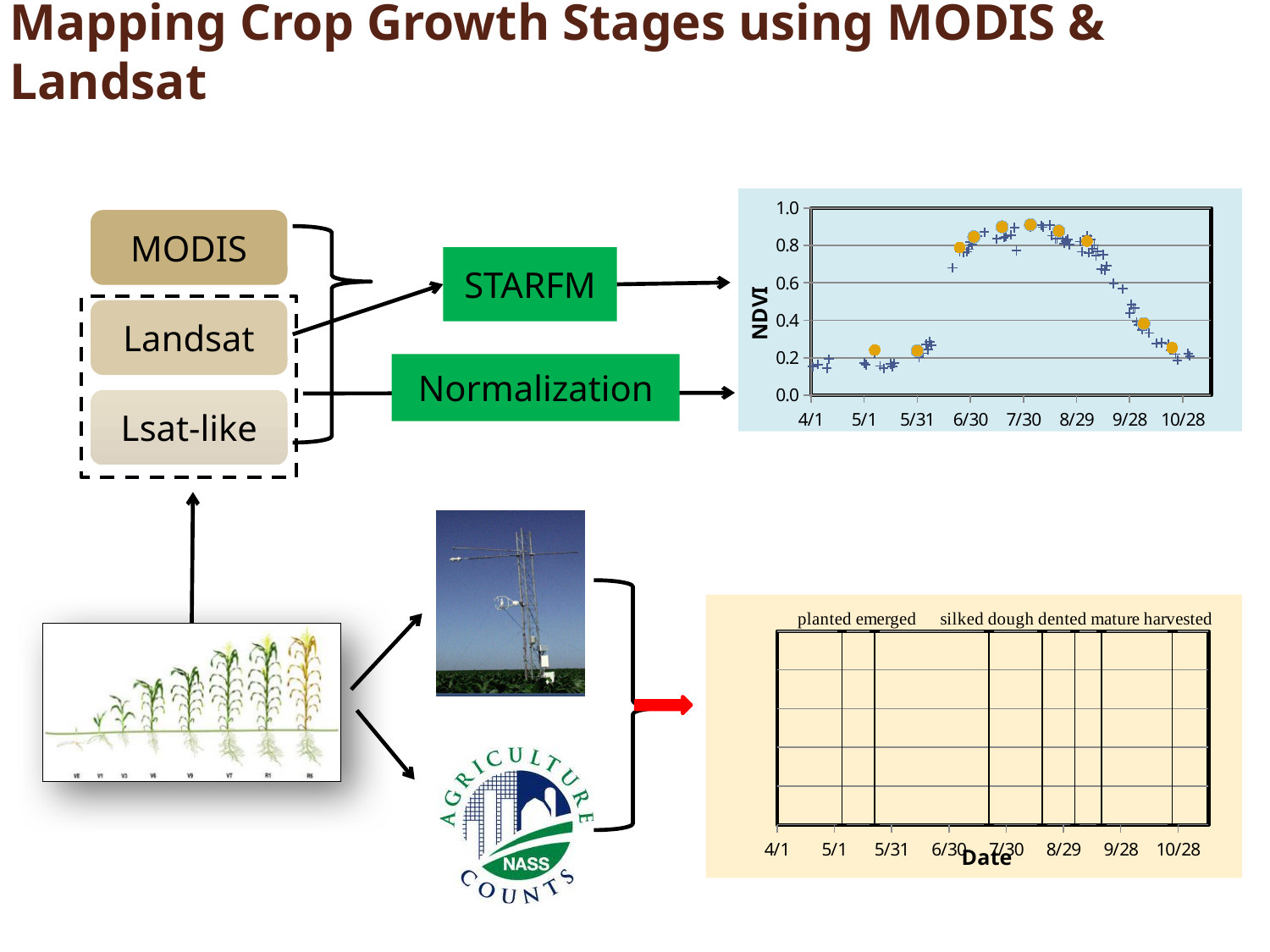
In the NDVI chart, are the NDVI values near 4/1 greater or less than 0.4? less In the crop growth stage chart at the bottom right, how many growth stages are labelled across the top? 7 In the crop growth stage chart at the bottom right, what is the title of the horizontal axis? Date In the NDVI chart, what is the highest value shown on the vertical axis? 1.0 In the NDVI chart, do the NDVI values rise or fall between 8/29 and 10/28? fall In the NDVI chart, around which date on the horizontal axis do the NDVI values reach their peak? 7/30 In the NDVI chart, what is the label on the vertical axis? NDVI In the NDVI chart, how many date tick labels are shown along the horizontal axis? 8 In the NDVI chart, is the NDVI value of the orange point near 7/30 greater or less than 0.8? greater In the NDVI chart, is the NDVI value of the orange point near 10/28 greater or less than 0.4? less In the NDVI chart, do the NDVI values rise or fall between 5/31 and 7/30? rise What kind of chart is the NDVI chart in the top right of the slide? scatter chart